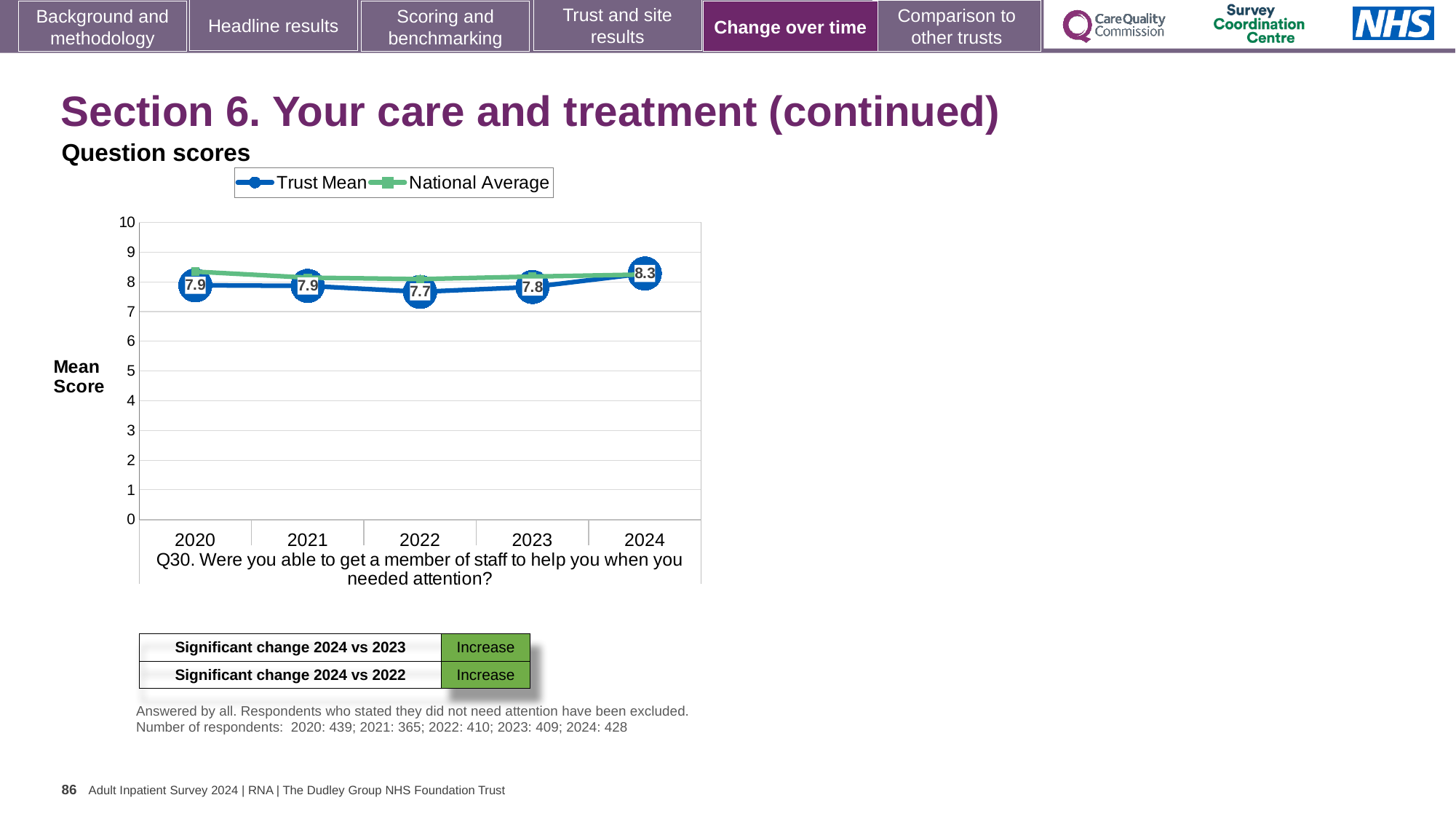
How many series does the legend list? 2 Is the National Average value for 2020 greater or less than 8? greater What is the Trust Mean score for 2024? 8.3 Which is larger, the Trust Mean score for 2021 or for 2022? 2021 What is the Trust Mean score for 2022? 7.7 In which year is the Trust Mean score highest? 2024 What is the Trust Mean score for 2020? 7.9 How many years are plotted on the x axis? 5 In which year is the Trust Mean score lowest? 2022 What is the difference between the Trust Mean scores for 2024 and 2023? 0.5 Does the Trust Mean score rise or fall from 2022 to 2024? Rise What kind of chart is shown? Line chart